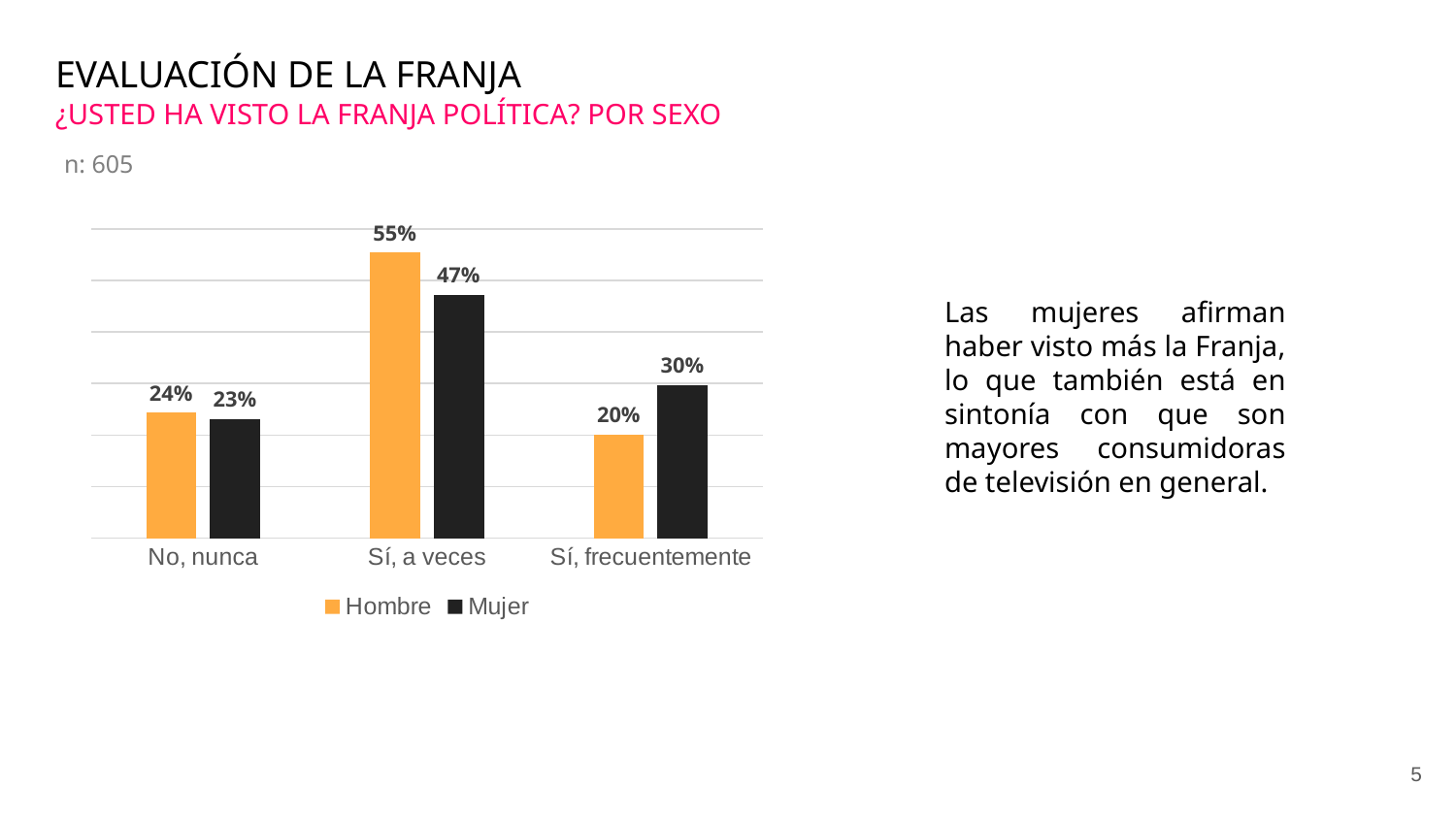
What is the difference between the Hombre and Mujer values in the "Sí, a veces" category? 8% What is the difference between the Mujer and Hombre values in the "Sí, frecuentemente" category? 10% What colour are the bars for the Hombre series? Orange What kind of chart is shown on the slide? Bar chart Which category has the lowest value for the Hombre series? Sí, frecuentemente How many categories are shown on the x axis of the chart? 3 What is the value for Hombre in the "Sí, a veces" category? 55% What is the value for Mujer in the "Sí, frecuentemente" category? 30% Which category has the highest value for the Mujer series? Sí, a veces In the "Sí, frecuentemente" category, which series has the larger value, Hombre or Mujer? Mujer What is the value for Mujer in the "No, nunca" category? 23% How many series does the legend list? 2